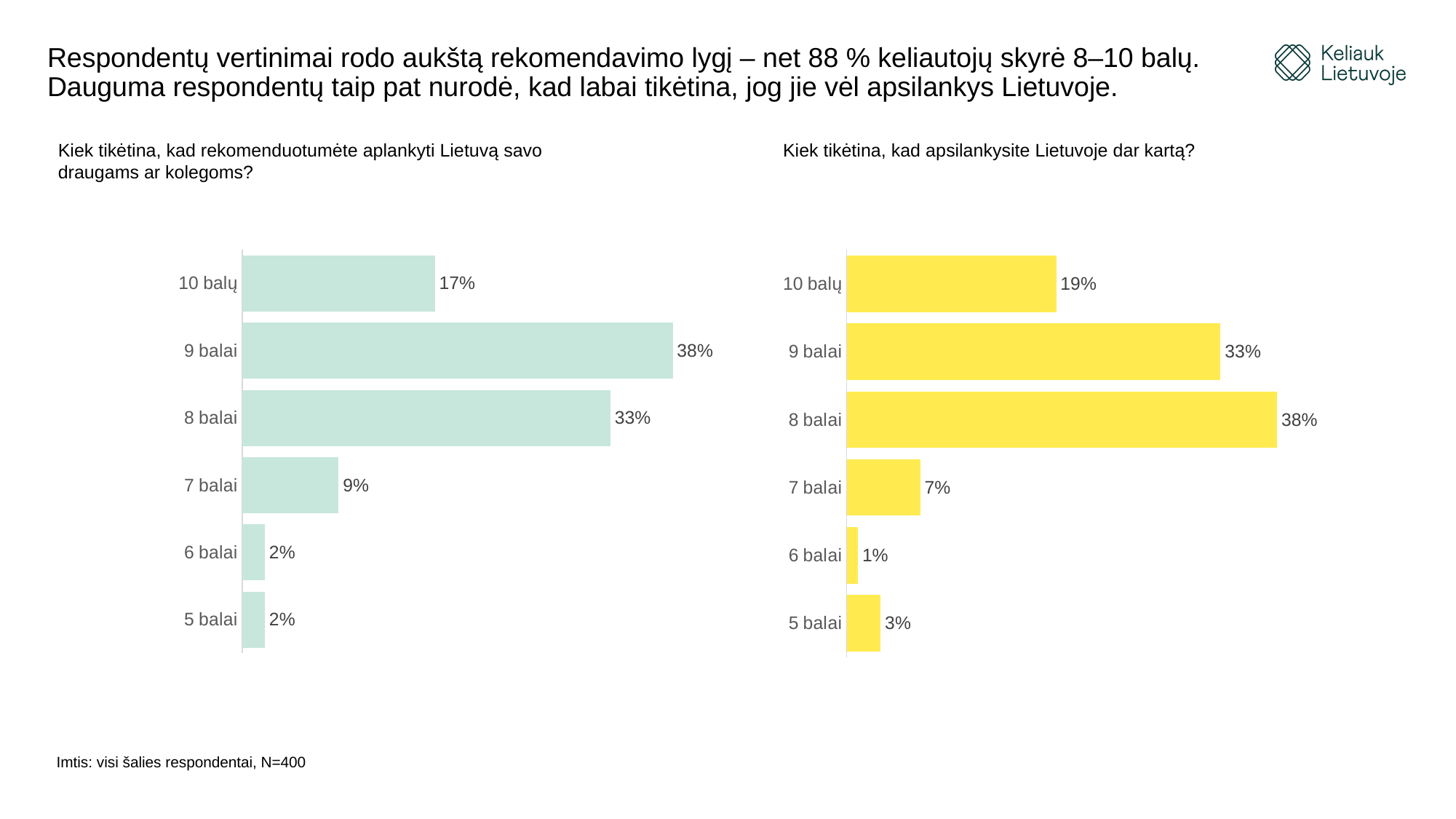
In the left chart, which is larger: the value for 10 balų or the value for 7 balai? 10 balų What kind of chart is the right chart? Bar chart In the left chart (Kiek tikėtina, kad rekomenduotumėte aplankyti Lietuvą savo draugams ar kolegoms?), what is the value for 9 balai? 38% In the left chart, which category has the highest value? 9 balai In the right chart, which is larger: the value for 5 balai or the value for 6 balai? 5 balai In the right chart, which category has the lowest value? 6 balai In the left chart, what is the difference between the values for 9 balai and 8 balai? 5% How many categories does the left chart show? 6 What colour are the bars in the right chart? Yellow In the right chart (Kiek tikėtina, kad apsilankysite Lietuvoje dar kartą?), what is the value for 10 balų? 19% In the right chart, which category has the highest value? 8 balai In the right chart, what is the difference between the values for 8 balai and 7 balai? 31%